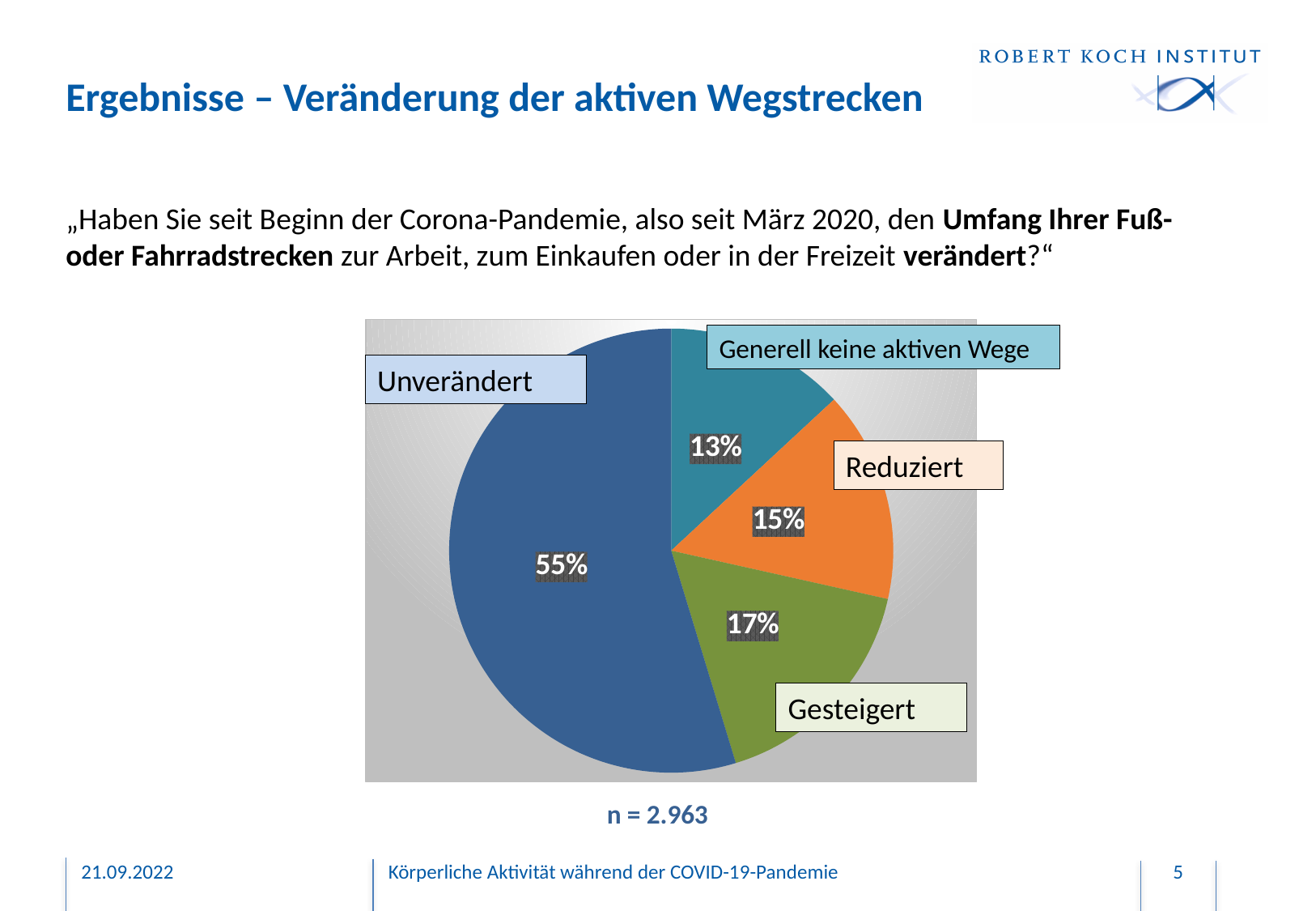
Which category has the largest slice of the pie? Unverändert Which category has the smallest slice of the pie? Generell keine aktiven Wege What share of the pie does the "Unverändert" slice represent? 55% What is the value shown for "Gesteigert"? 17% What kind of chart is shown on the slide? Pie chart Which is larger, the slice for "Reduziert" or the slice for "Generell keine aktiven Wege"? Reduziert What is the value shown for "Reduziert"? 15% What is the difference in percentage points between "Gesteigert" and "Reduziert"? 2 How many slices does the pie chart have? 4 What sample size (n) is stated below the chart? n = 2.963 What is the difference in percentage points between "Unverändert" and "Gesteigert"? 38 What is the value shown for "Generell keine aktiven Wege"? 13%